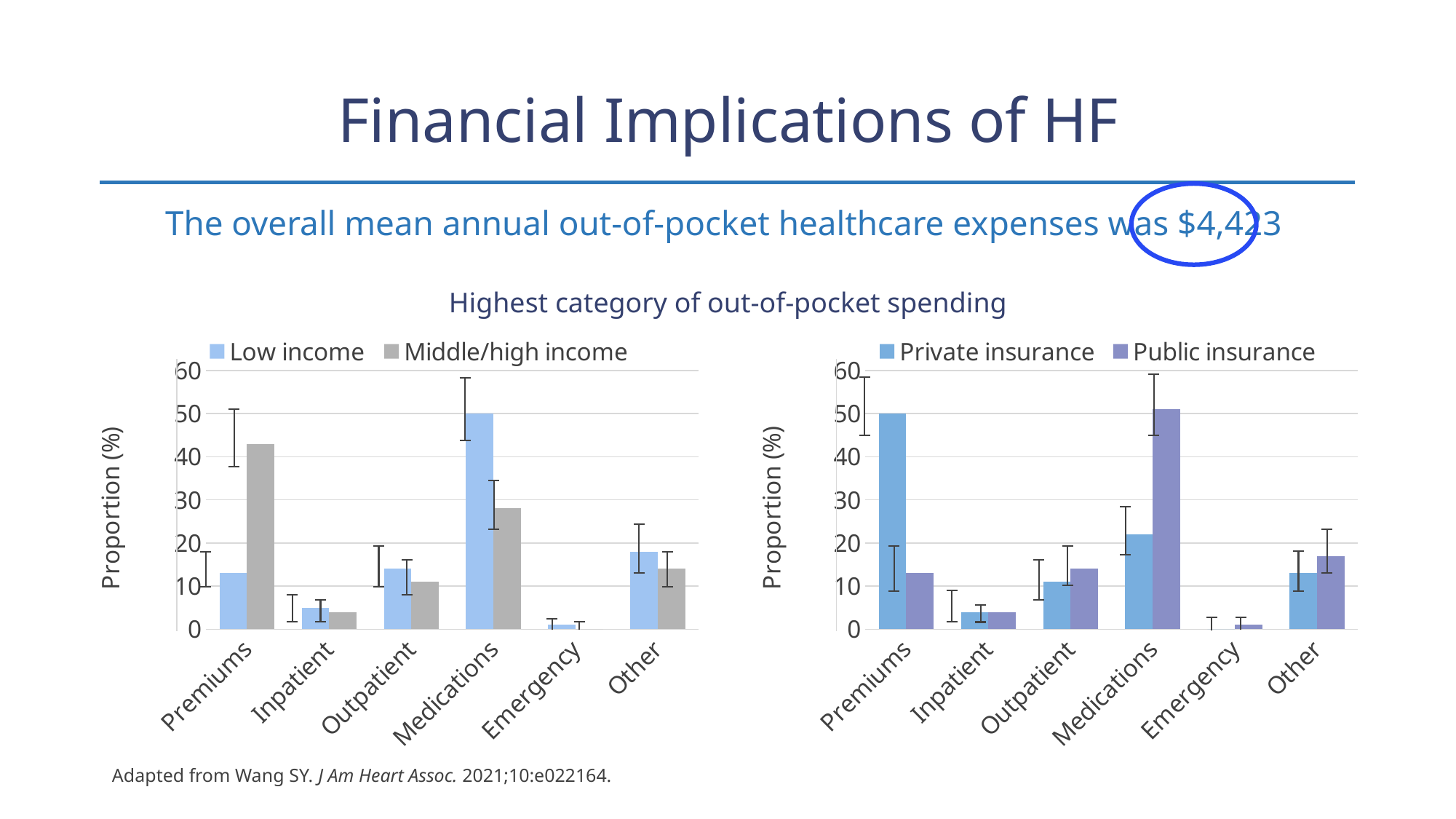
In the left chart (Low income vs Middle/high income), which group has the larger proportion for Premiums? Middle/high income In the right chart (Private insurance vs Public insurance), which group has the larger proportion for Premiums? Private insurance In the left chart (Low income vs Middle/high income), which category has the highest proportion for Low income? Medications In the right chart (Private insurance vs Public insurance), which category has the highest proportion for Public insurance? Medications In the left chart (Low income vs Middle/high income), is the Middle/high income value for Medications greater or less than 30? less In the right chart (Private insurance vs Public insurance), is the Private insurance value for Medications greater or less than 30? less In the left chart (Low income vs Middle/high income), which category has the highest proportion for Middle/high income? Premiums How many spending categories are shown on the x axis of the left chart (Low income vs Middle/high income)? 6 What kind of chart is the right chart (Private insurance vs Public insurance)? Bar chart In the left chart (Low income vs Middle/high income), is the Low income value for Medications greater or less than 40? greater In the left chart (Low income vs Middle/high income), which category has the lowest proportion for Low income? Emergency